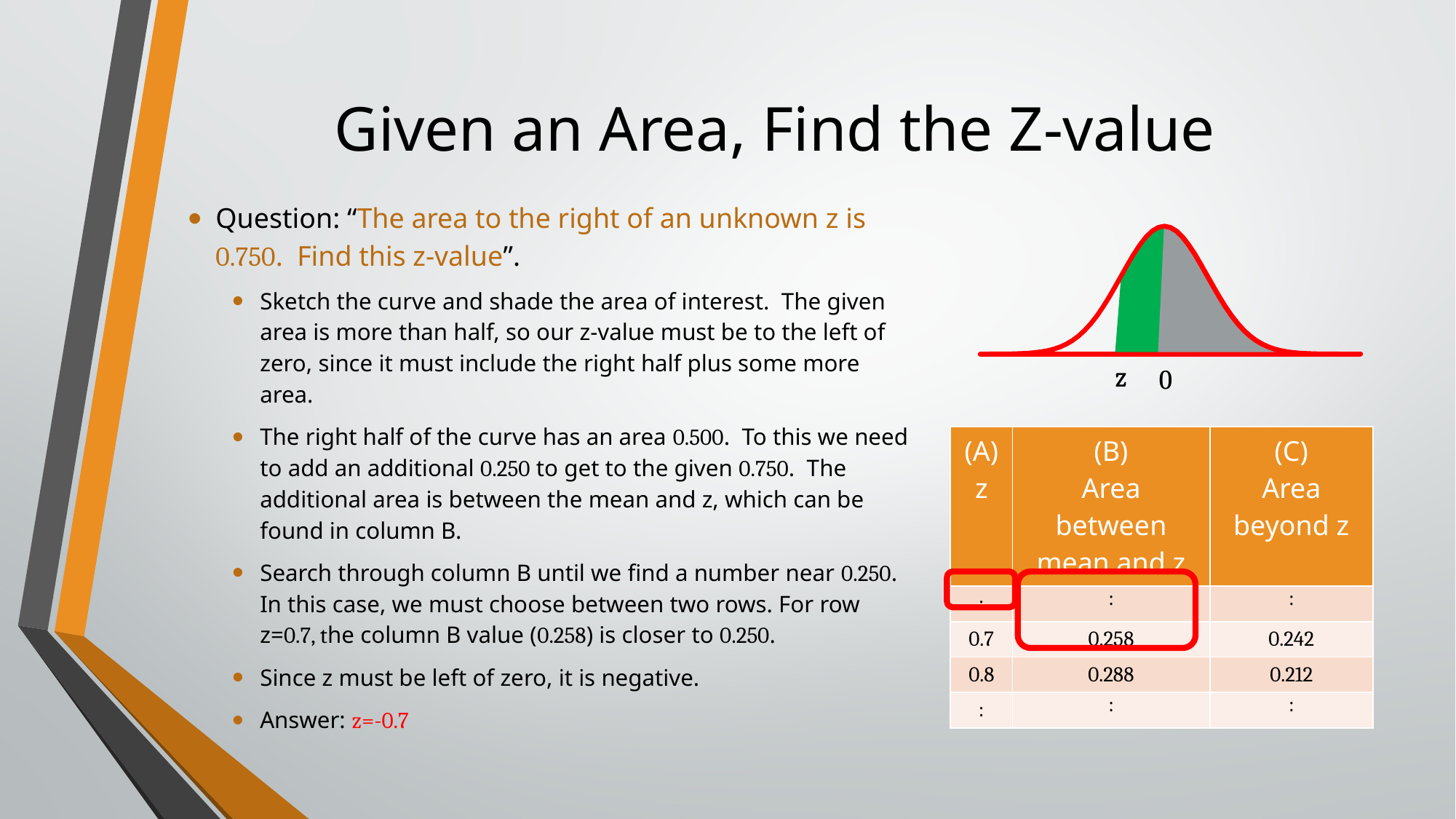
In the table, which z row has the larger area between mean and z, 0.7 or 0.8? 0.8 In the table, what is the column C value (area beyond z) for z = 0.8? 0.212 In the table, what is the sum of the column B and column C values for z = 0.7? 0.500 What kind of chart is shown at the top right of the slide? An area chart (a bell-shaped normal distribution curve with shaded regions) In the table, what is the difference between the column B values for z = 0.8 and z = 0.7? 0.030 In the curve at the top right, what colour is the shaded area between z and 0? Green What two labels appear on the horizontal axis of the curve at the top right? z and 0 In the table, what is the column B value (area between mean and z) for z = 0.7? 0.258 How many columns does the table on the slide have? 3 In the table, what is the column B value (area between mean and z) for z = 0.8? 0.288 In the table, what is the column C value (area beyond z) for z = 0.7? 0.242